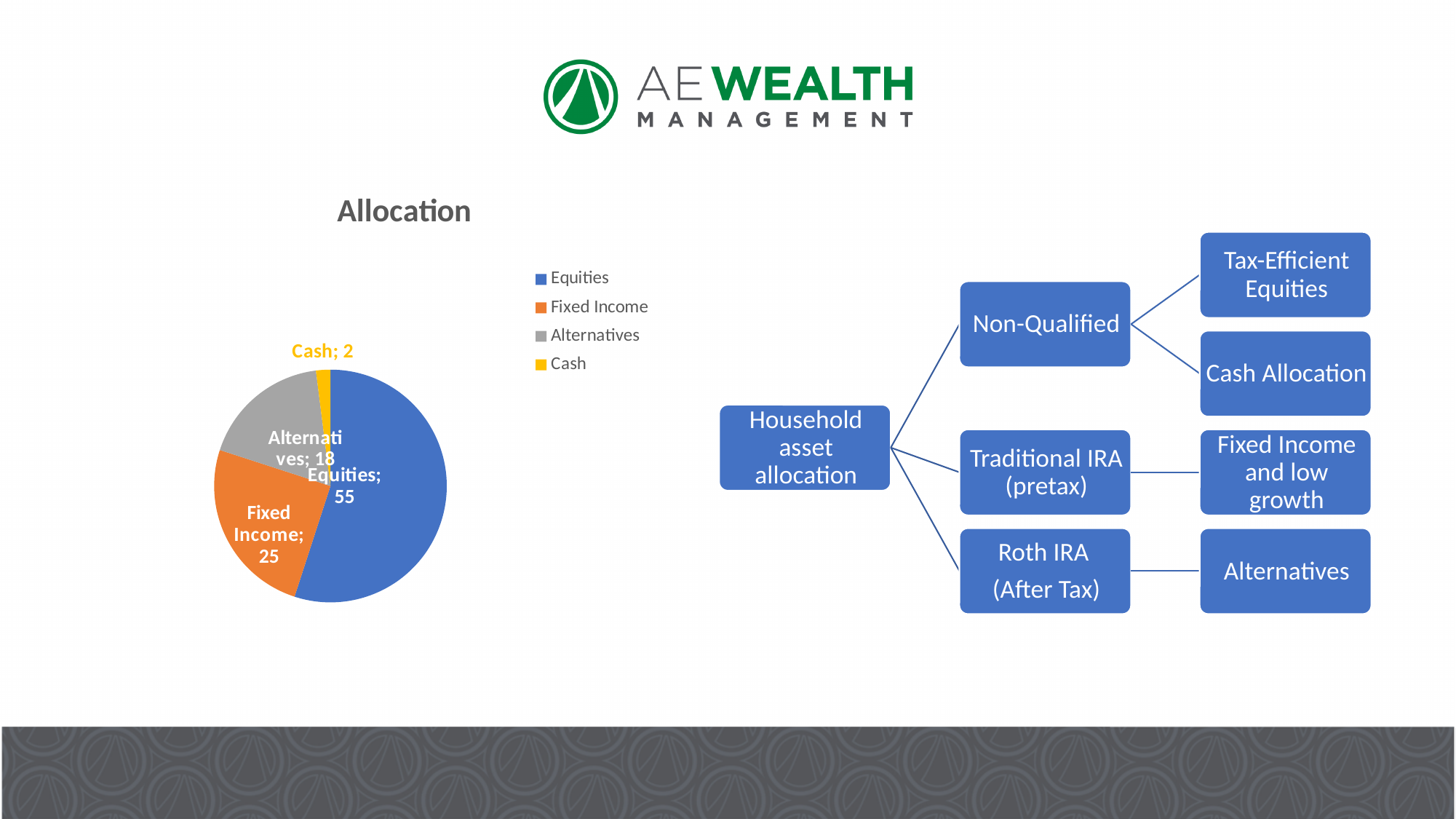
What colour is the Fixed Income slice in the Allocation pie chart? orange What is the value for Fixed Income in the Allocation pie chart? 25 What is the value for Equities in the Allocation pie chart? 55 What type of chart is shown under the title "Allocation"? pie chart Which is larger in the Allocation pie chart, Fixed Income or Alternatives? Fixed Income Which category has the largest slice in the Allocation pie chart? Equities What is the value for Alternatives in the Allocation pie chart? 18 How many categories are shown in the Allocation pie chart? 4 What is the value for Cash in the Allocation pie chart? 2 What share of the Allocation pie does Equities represent? 55% What is the difference between the Equities and Fixed Income values in the Allocation pie chart? 30 Which category has the smallest slice in the Allocation pie chart? Cash